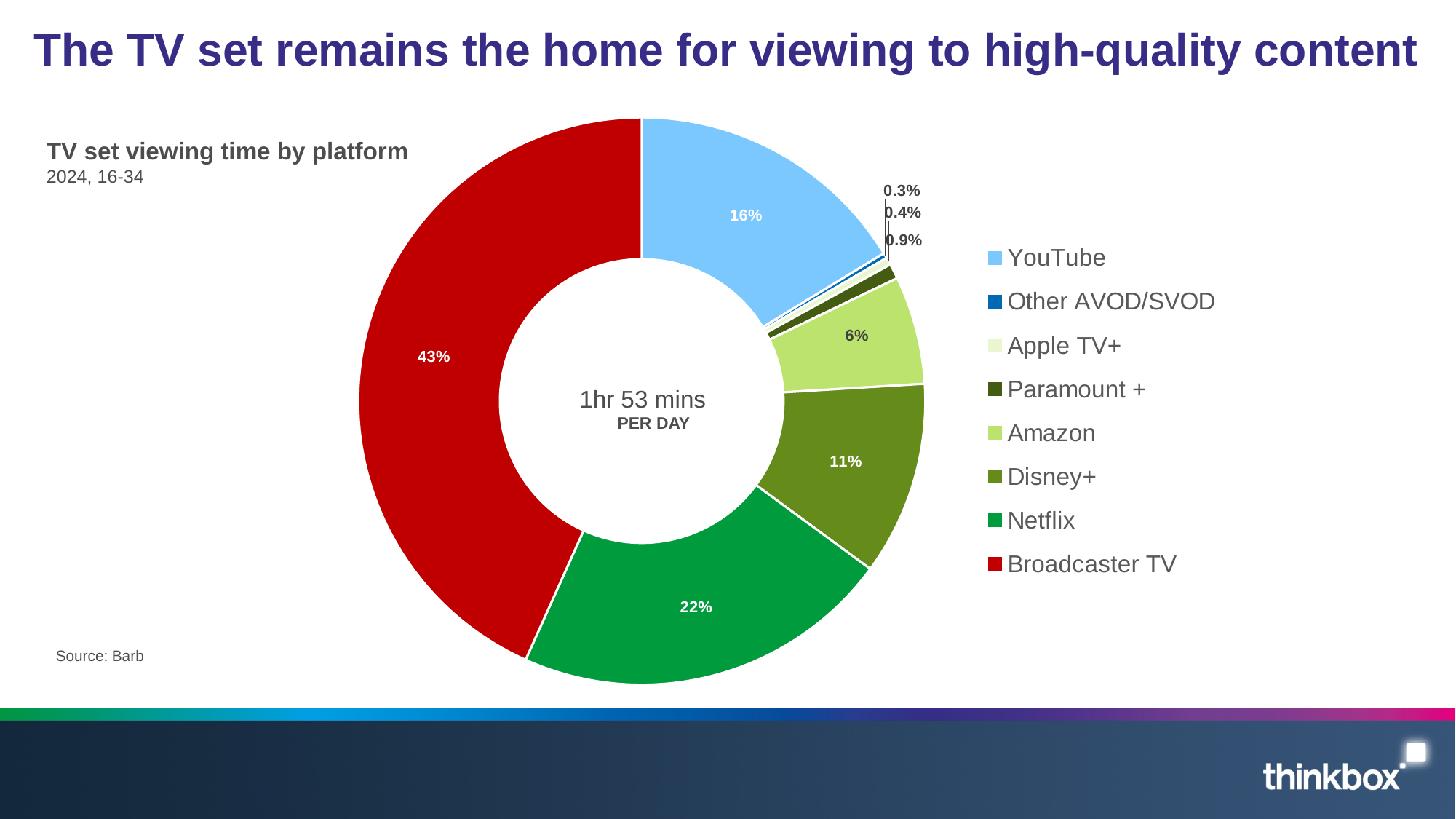
Which has a larger share, YouTube or Disney+? YouTube What share of TV set viewing time does Broadcaster TV account for? 43% What is the value shown for Disney+? 11% How many platforms are listed in the legend? 8 What is the value shown for Netflix? 22% What is the title of the chart? TV set viewing time by platform What is the difference in percentage points between Broadcaster TV and Netflix? 21 percentage points Which platform has the largest share of TV set viewing time? Broadcaster TV What is the value shown for YouTube? 16% What total viewing time per day is shown in the centre of the chart? 1hr 53 mins What kind of chart is shown on the slide? Pie chart (donut) What is the value shown for Amazon? 6%